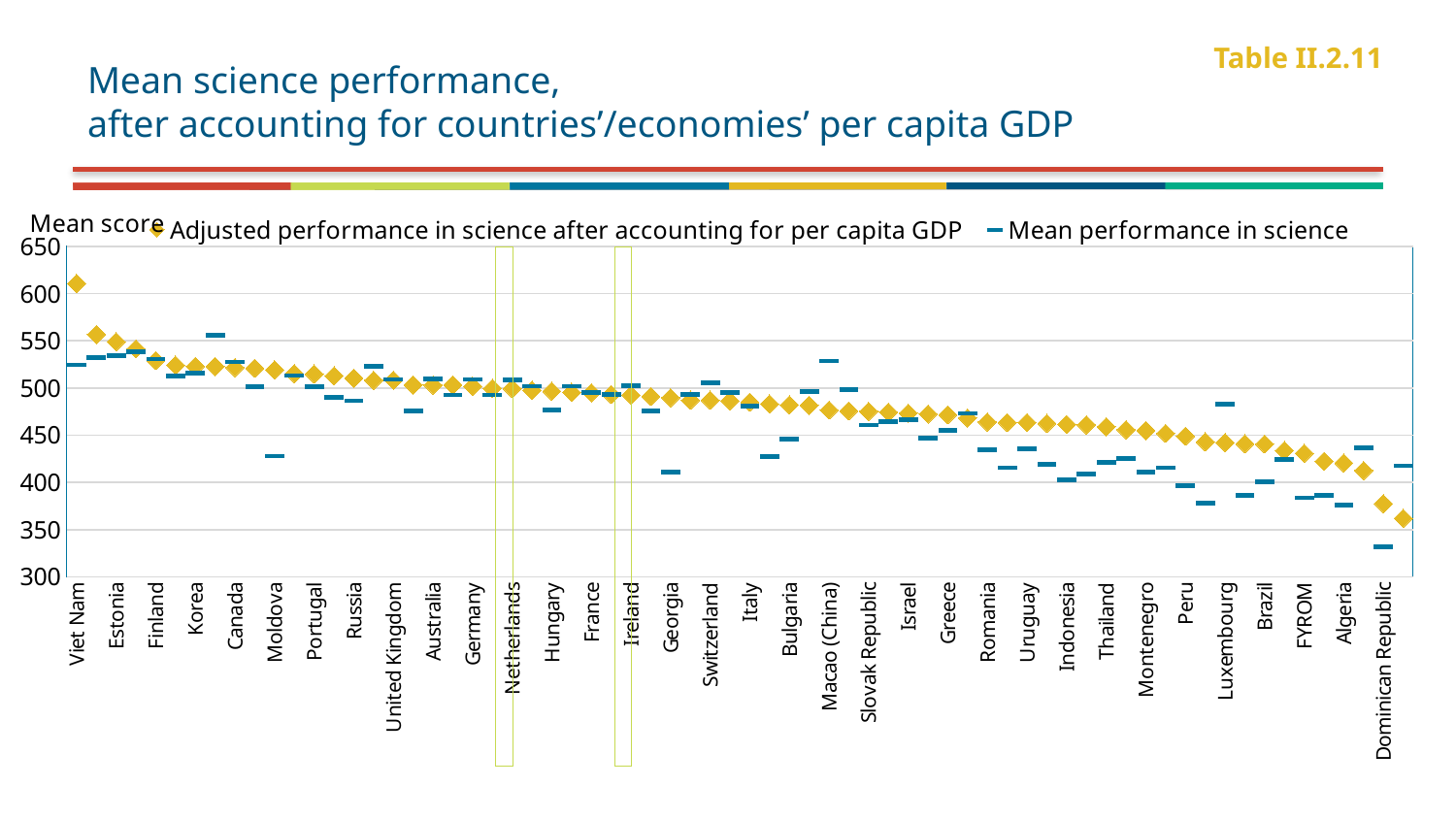
How many series does the legend list? 2 Is the adjusted performance in science for the Dominican Republic greater or less than 400? less What kind of chart is shown on the slide? scatter chart Do the adjusted performance values rise or fall from left to right along the x axis? fall For Luxembourg, which is larger: the adjusted performance in science or the mean performance in science? mean performance in science Is the mean performance in science for the Dominican Republic greater or less than 350? less Is the mean performance in science for Moldova greater or less than 450? less For Viet Nam, which is larger: the adjusted performance in science or the mean performance in science? adjusted performance in science Which two countries are highlighted with boxes on the chart? Netherlands and Ireland Which country has the highest adjusted performance in science after accounting for per capita GDP? Viet Nam